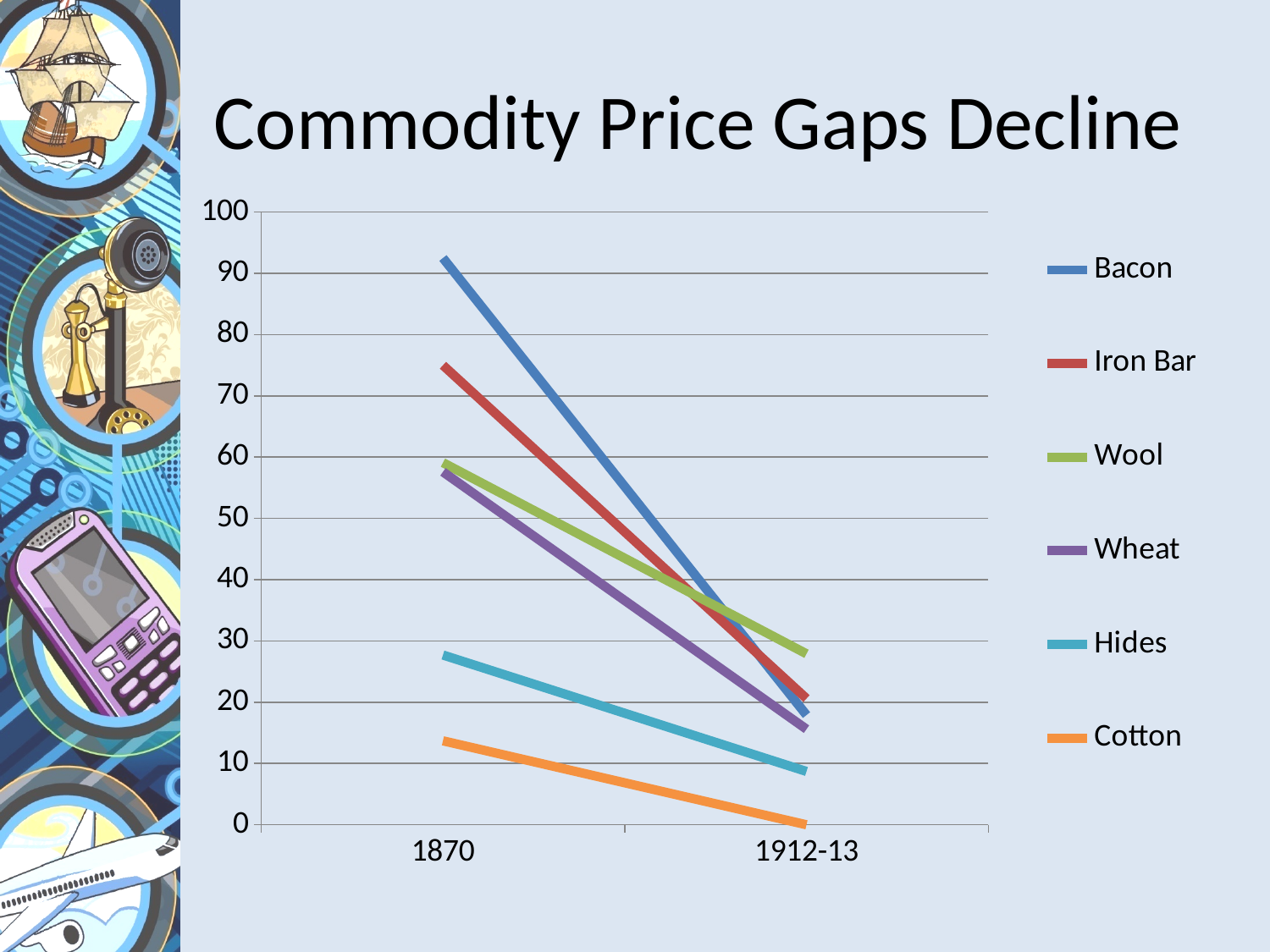
Is the value for Hides in 1912-13 greater or less than 10? less Which commodity has the highest value in 1870? Bacon Which commodity has the lowest value in 1912-13? Cotton Which is larger in 1870, the value for Iron Bar or the value for Wool? Iron Bar Do the values for Bacon rise or fall from 1870 to 1912-13? fall Which commodity has the lowest value in 1870? Cotton How many points are shown on the x axis? 2 What kind of chart is shown on the slide? line chart What is the title of the chart? Commodity Price Gaps Decline Is the value for Bacon in 1870 greater or less than 90? greater Which commodity has the highest value in 1912-13? Wool How many series does the legend list? 6